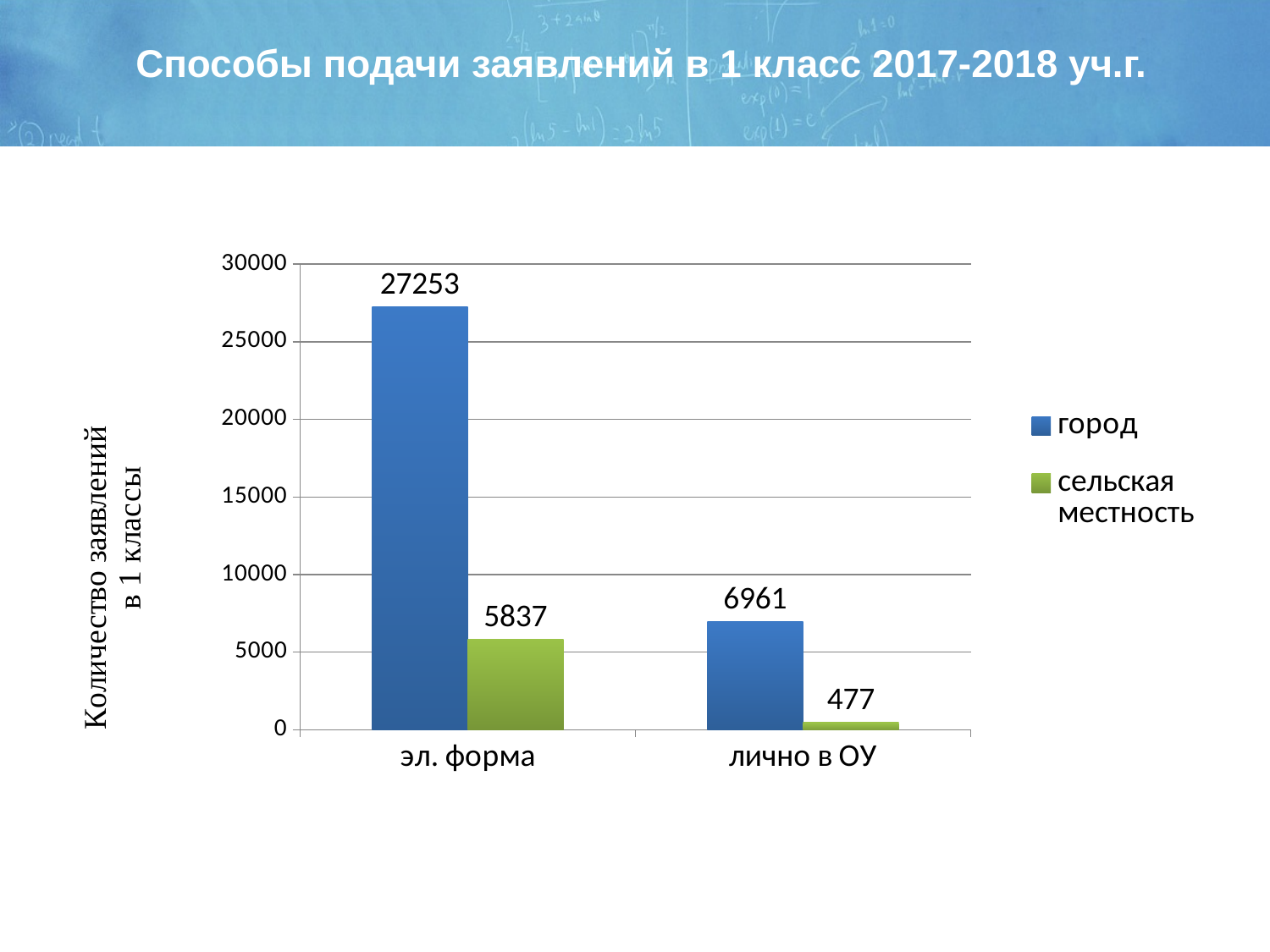
What is the difference between the город and сельская местность values for эл. форма? 21416 Which is larger: сельская местность for эл. форма or город for лично в ОУ? город for лично в ОУ Which bar has the lowest value on the chart? сельская местность, лично в ОУ Which bar has the highest value on the chart? город, эл. форма What is the value for сельская местность in the эл. форма category? 5837 How many series does the legend list? 2 What is the value for сельская местность in the лично в ОУ category? 477 What is the value for город in the эл. форма category? 27253 What kind of chart is shown on the slide? bar chart What is the value for город in the лично в ОУ category? 6961 What is the difference between the город values for эл. форма and лично в ОУ? 20292 How many categories are shown on the x axis? 2